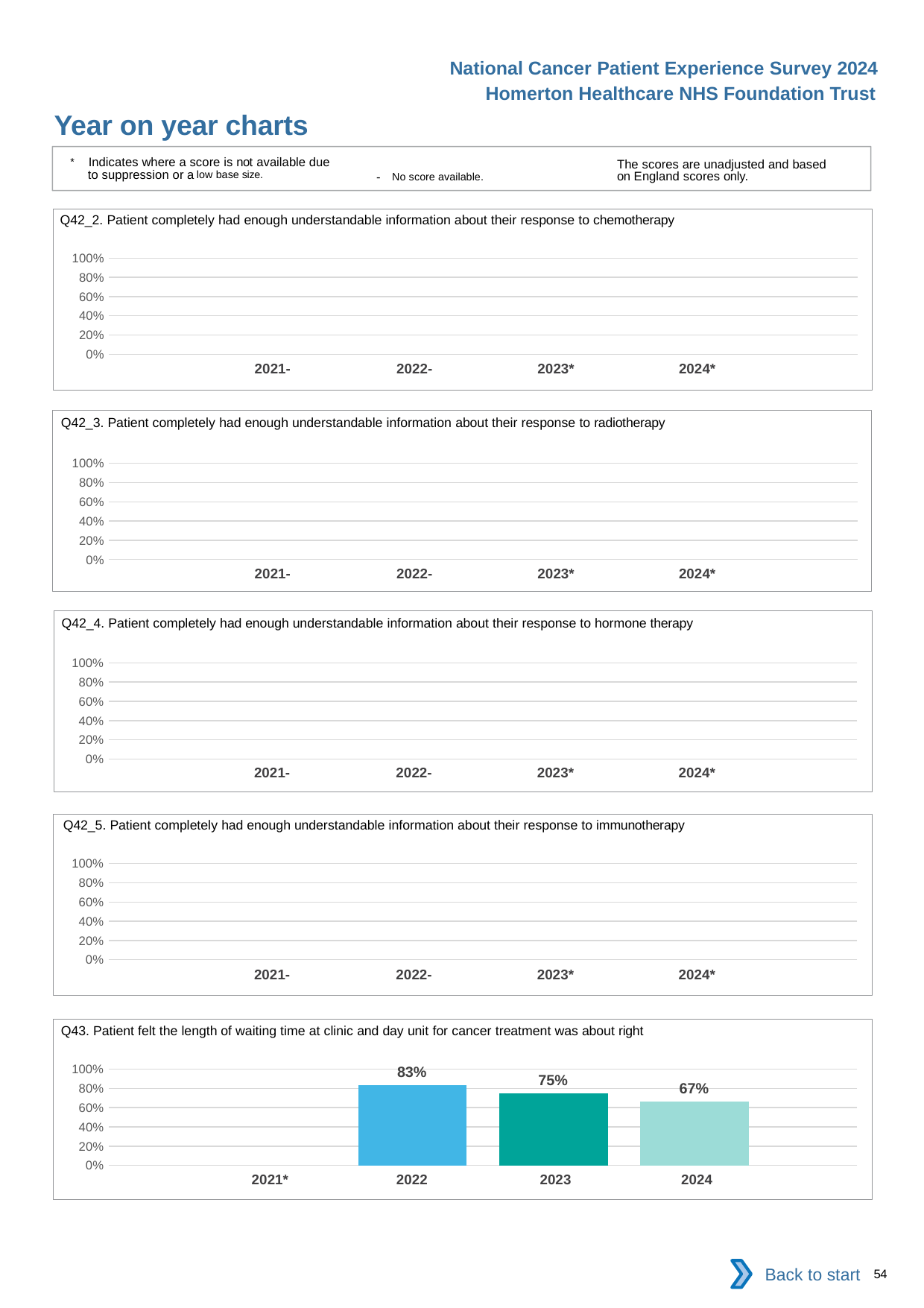
In the Q43 chart, is the value for 2024 greater or less than 80%? less In the Q43 chart, what is the value for 2023? 75% In the Q43 chart, what is the value for 2024? 67% In the Q43 chart, which is larger, the value for 2022 or the value for 2023? 2022 In the Q43 chart, which year has the highest value? 2022 What kind of chart is the Q43 chart at the bottom of the slide? bar chart In the Q43 chart, do the values rise or fall from 2022 to 2024? fall In the Q43 chart, what is the difference between the 2022 and 2024 values? 16% In the Q43 chart, what is the difference between the 2023 and 2024 values? 8% In the Q43 chart, what is the value for 2022? 83% How many bars are plotted in the Q43 chart? 3 In the Q43 chart, which year with a plotted bar has the lowest value? 2024